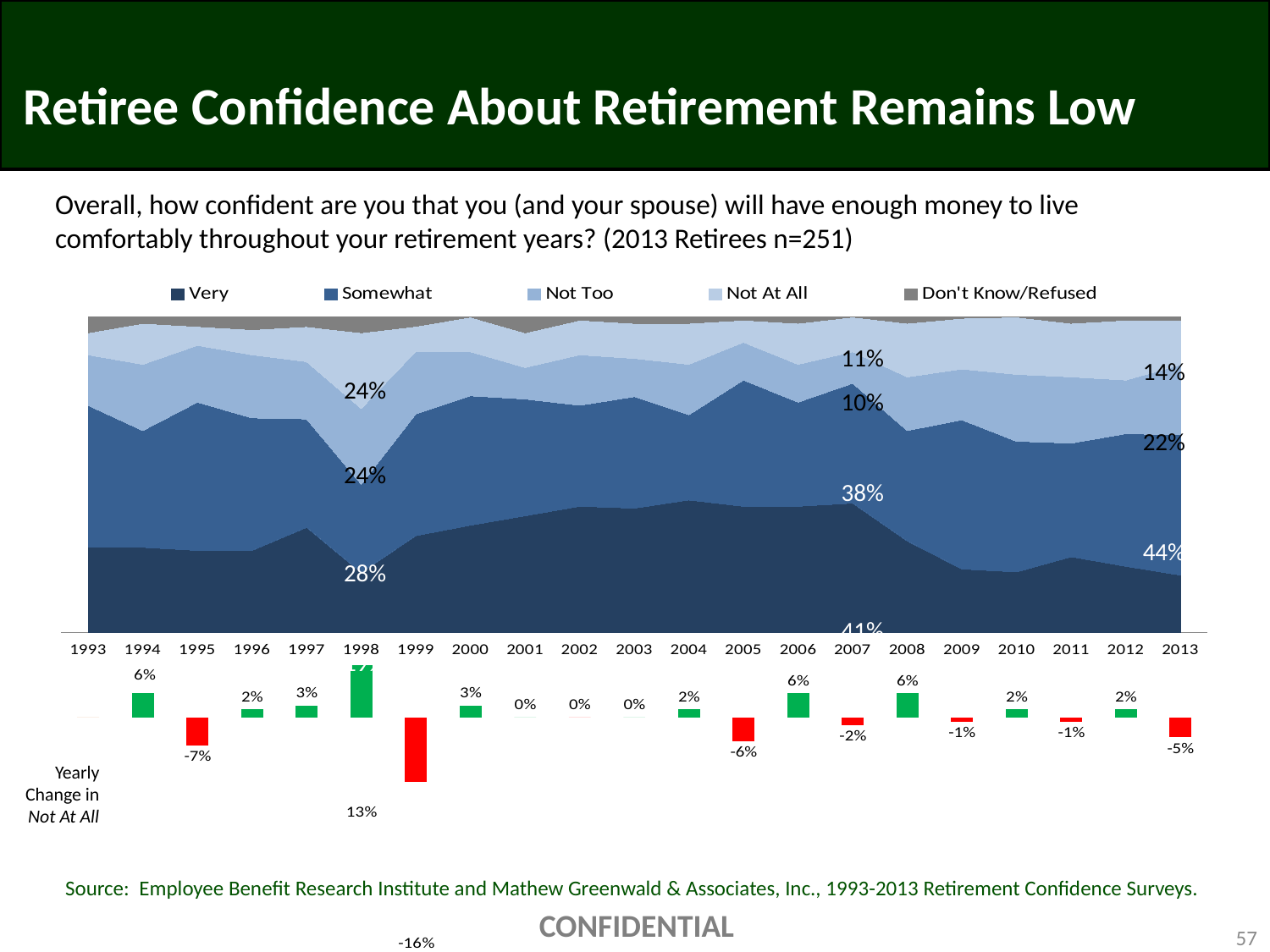
How many series does the legend of the top chart list? 5 What is the first entry in the legend of the top chart? Very In the bottom 'Yearly Change in Not At All' bar chart, what is the value for 1994? 6% In the bottom 'Yearly Change in Not At All' bar chart, what is the difference between the 2008 value and the 2007 value? 8 percentage points In the bottom 'Yearly Change in Not At All' bar chart, what is the value for 2013? -5% In the bottom 'Yearly Change in Not At All' bar chart, which year shows the largest decrease? 1999 What kind of chart is the bottom 'Yearly Change in Not At All' chart? Bar chart In the bottom 'Yearly Change in Not At All' bar chart, which is larger, the value for 2005 or the value for 2006? 2006 How many years are shown along the x axis of the top chart? 21 In the bottom 'Yearly Change in Not At All' bar chart, how many years show a change of 0%? 3 In the bottom 'Yearly Change in Not At All' bar chart, which year shows the largest increase? 1998 In the bottom 'Yearly Change in Not At All' bar chart, what is the value for 1995? -7%